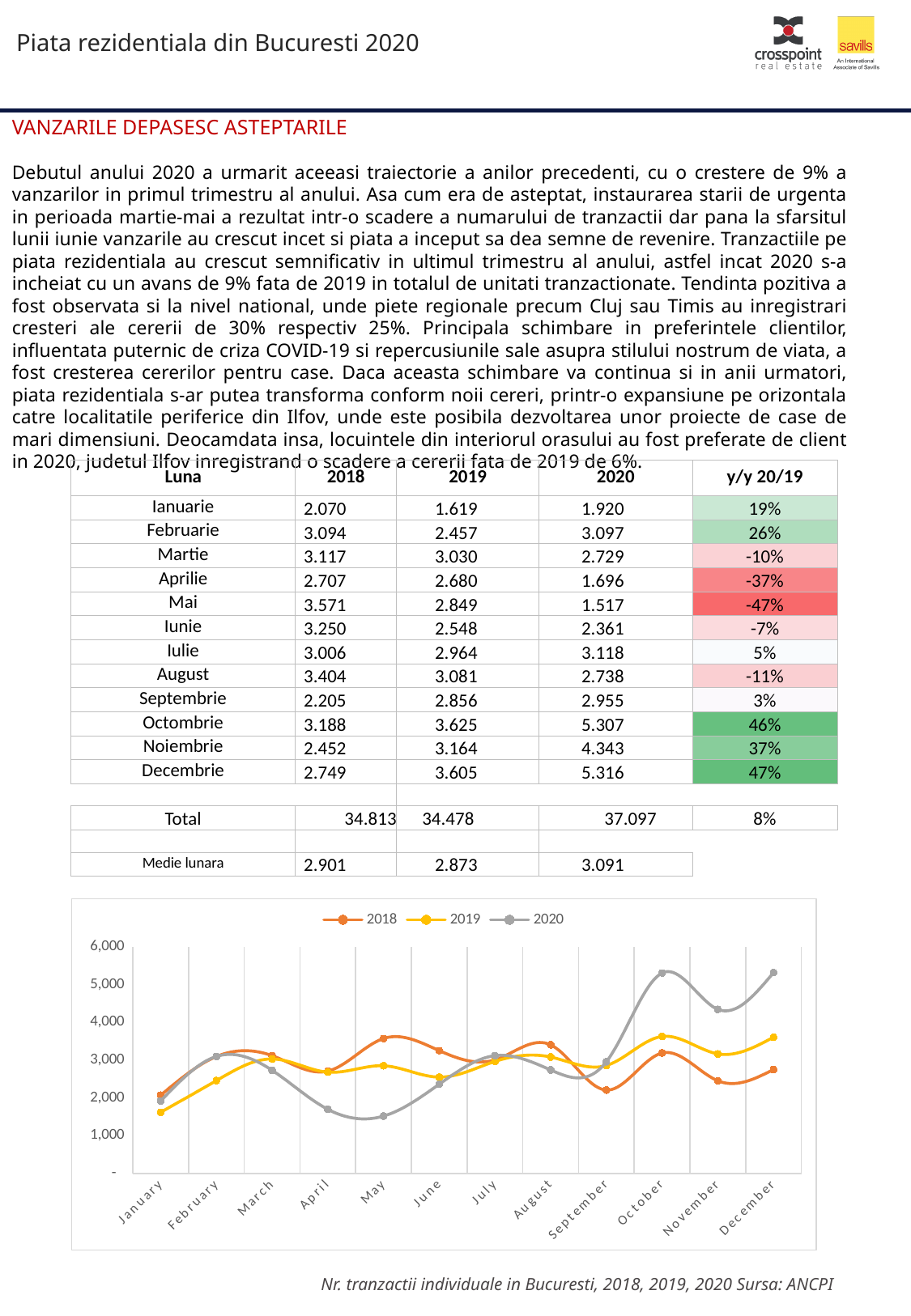
Is the value for 2020 in October greater or less than 5,000? greater What are the three series listed in the chart legend? 2018, 2019, 2020 Which series does the chart legend show in grey? 2020 Is the value for 2020 in May greater or less than 2,000? less In October, which series has the larger value, 2019 or 2020? 2020 In which month is the 2019 series at its lowest value? January Is the value for 2018 in May greater or less than 3,000? greater How many months are plotted along the x axis of the chart? 12 What kind of chart is shown on the slide? line chart Does the 2020 series rise or fall from February to May? fall How many series does the chart legend list? 3